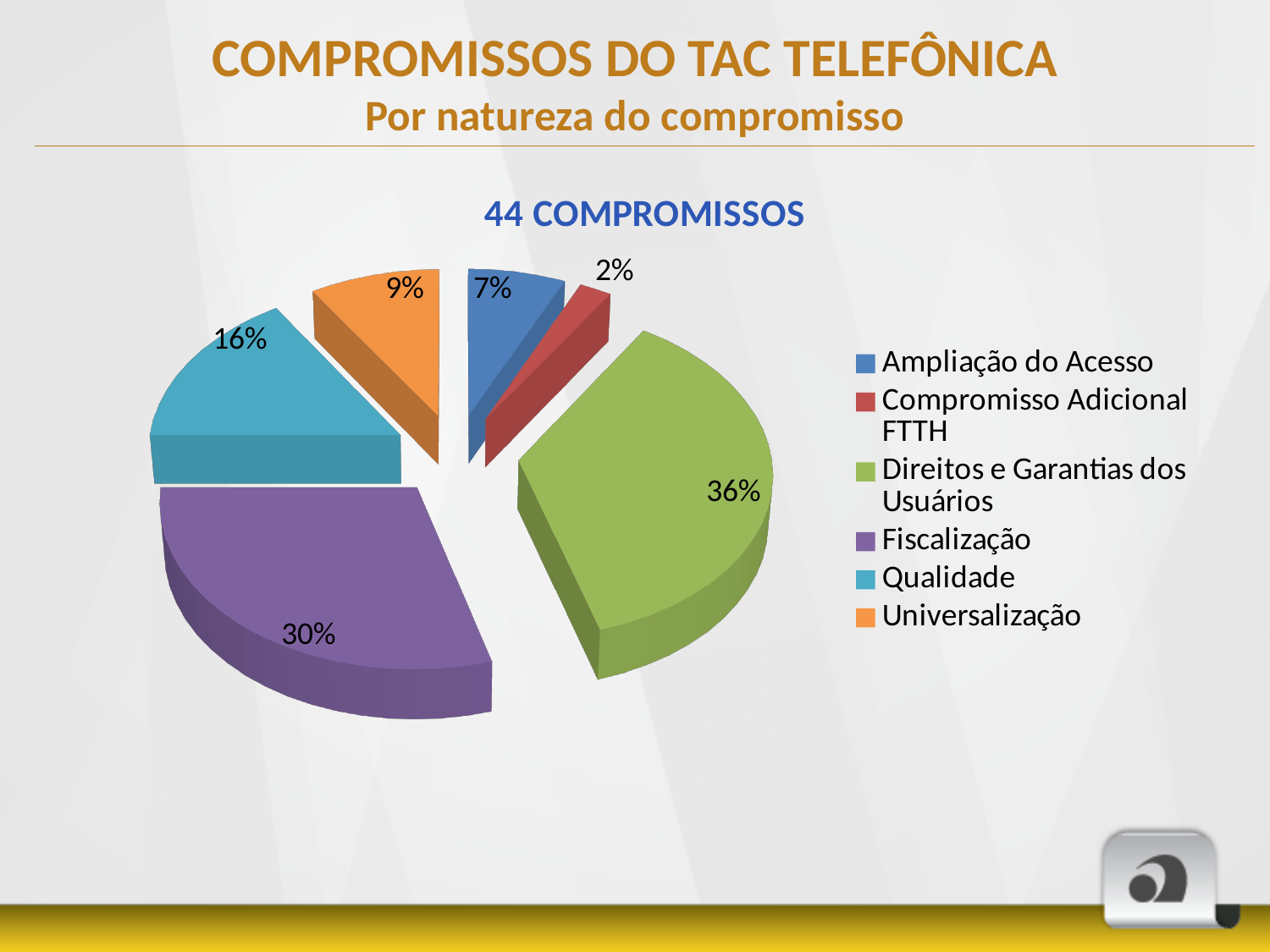
Which is larger, the share for Universalização or the share for Ampliação do Acesso? Universalização Which colour represents Qualidade in the legend? Teal (light blue) Which category has the smallest slice of the pie? Compromisso Adicional FTTH What share of the pie does Fiscalização represent? 30% What share of the pie does Direitos e Garantias dos Usuários represent? 36% Which category has the largest slice of the pie? Direitos e Garantias dos Usuários What share of the pie does Compromisso Adicional FTTH represent? 2% What type of chart is shown on the slide? Pie chart How many slices does the pie chart have? 6 What is the difference in percentage points between Fiscalização and Qualidade? 14 percentage points What is the chart's title? 44 COMPROMISSOS